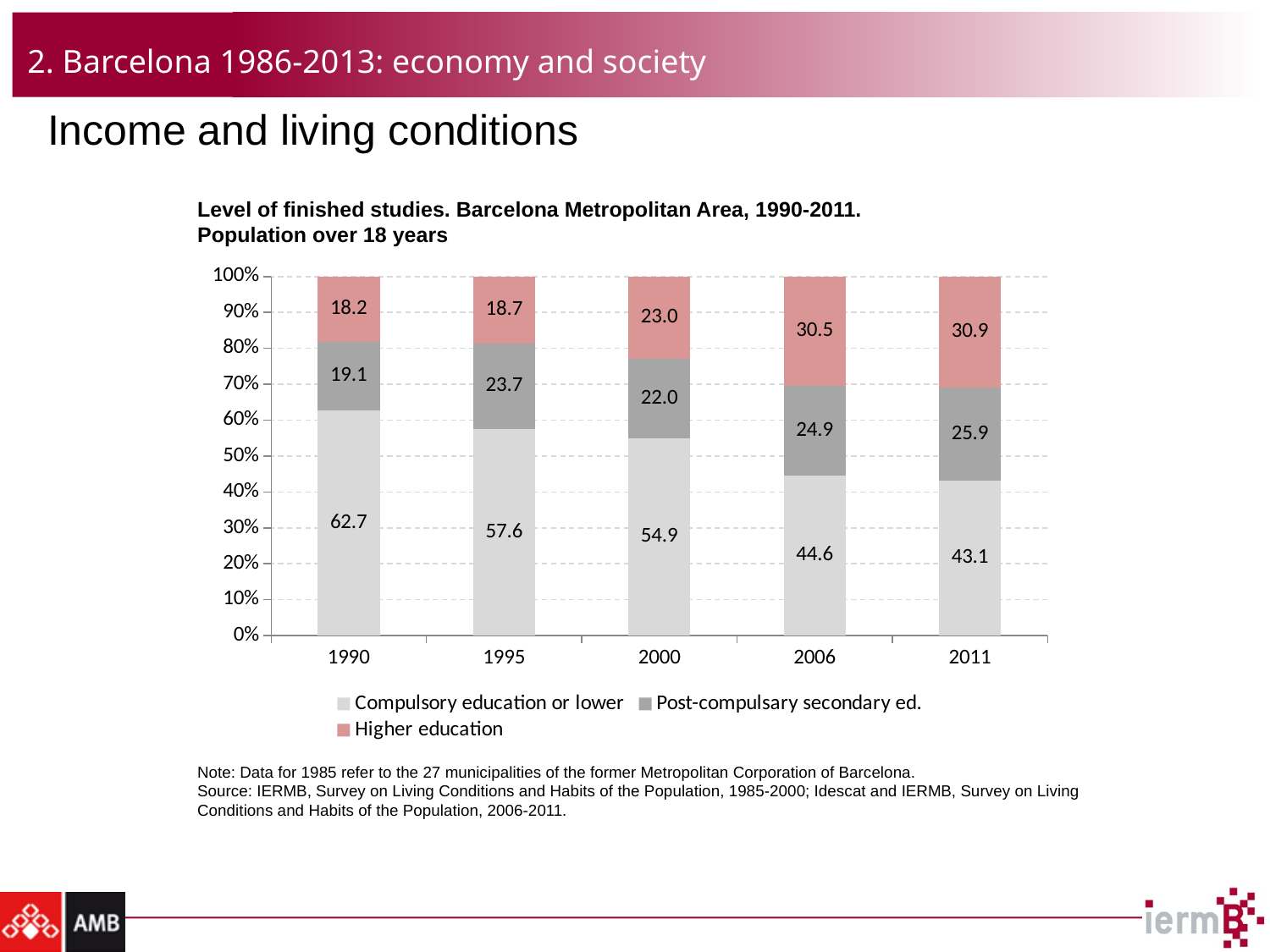
What is the value for Compulsory education or lower in 1990? 62.7 In which year is the Higher education share lowest? 1990 Which series is shown in the darkest grey colour? Post-compulsary secondary ed. How many series does the legend list? 3 What kind of chart is this? Stacked bar chart Which is larger: Higher education in 2006 or Post-compulsary secondary ed. in 2006? Higher education in 2006 What is the value for Post-compulsary secondary ed. in 2000? 22.0 Does the Compulsory education or lower share rise or fall from 1990 to 2011? Fall What is the value for Higher education in 2011? 30.9 What is the difference between the Compulsory education or lower values for 1990 and 2011? 19.6 In which year is the Compulsory education or lower share highest? 1990 How many years are shown on the x axis? 5